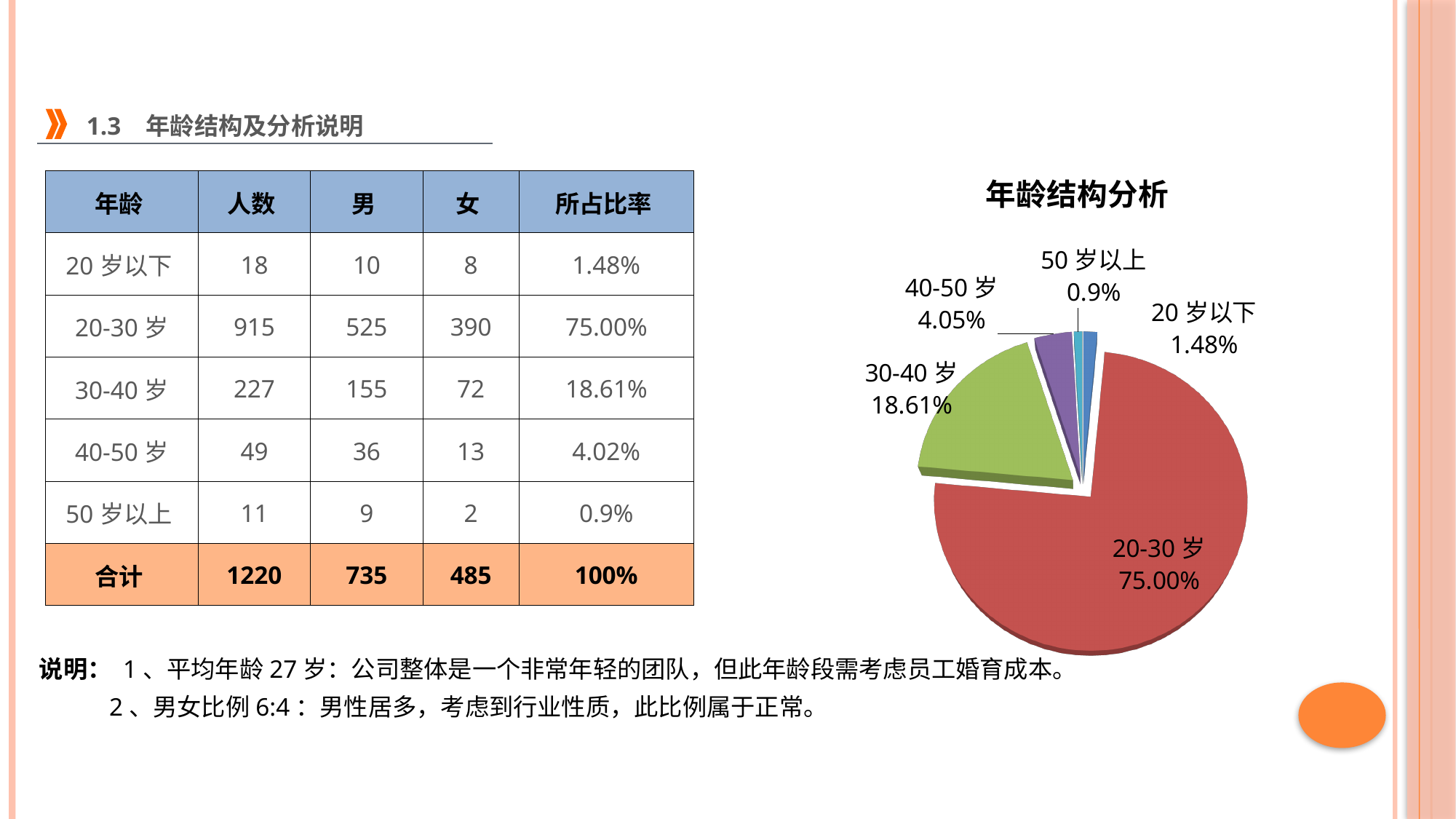
Which age group has the largest slice of the pie? 20-30 岁 What share of the pie does the 20-30 岁 slice represent? 75.00% Which age group has the smallest slice of the pie? 50 岁以上 How many slices does the pie chart have? 5 What percentage is shown for the 50 岁以上 slice in the chart? 0.9% What share of the pie does the 30-40 岁 slice represent? 18.61% What is the difference in percentage between the 20-30 岁 slice and the 30-40 岁 slice? 56.39% What percentage is shown for the 20 岁以下 slice in the chart? 1.48% Which slice is larger, 30-40 岁 or 40-50 岁? 30-40 岁 What percentage is shown for the 40-50 岁 slice in the chart? 4.05% What is the title of the chart? 年龄结构分析 What type of chart is shown on the slide? pie chart